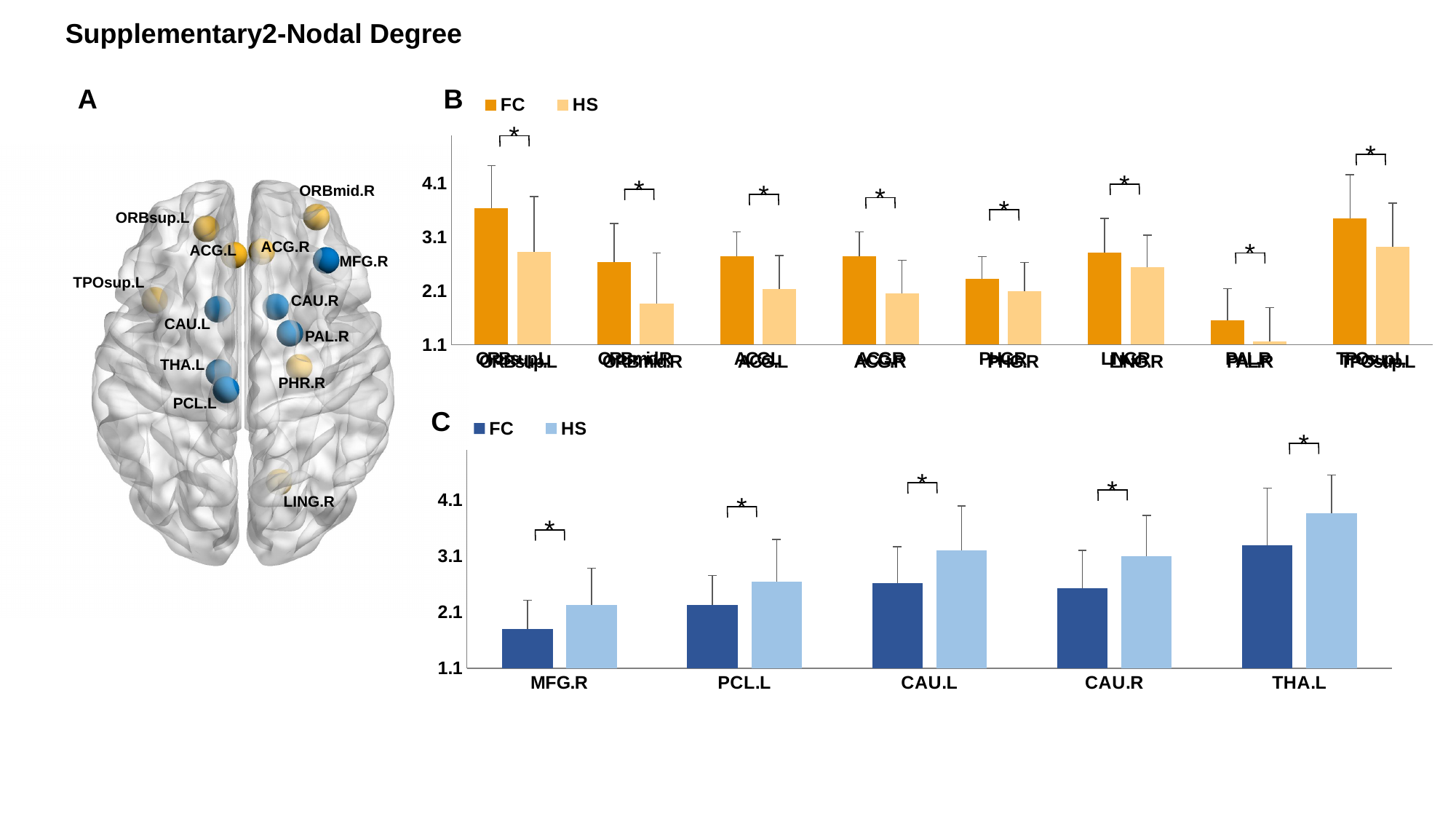
How many categories are shown on the x axis of chart B? 8 In chart C, which category has the highest HS value? THA.L What kind of chart is chart B on the slide? bar chart How many series does the legend of chart C list? 2 What are the two legend entries of chart B? FC and HS How many categories are shown on the x axis of chart C? 5 In chart B, which category has the lowest FC value? PAL.R In chart B, is the FC value for ORBsup.L greater or less than 3.1? greater In chart B, is the HS value for PAL.R greater or less than 2.1? less In chart C, is the FC value for MFG.R greater or less than 2.1? less In chart C, for THA.L, which series has the larger value, FC or HS? HS